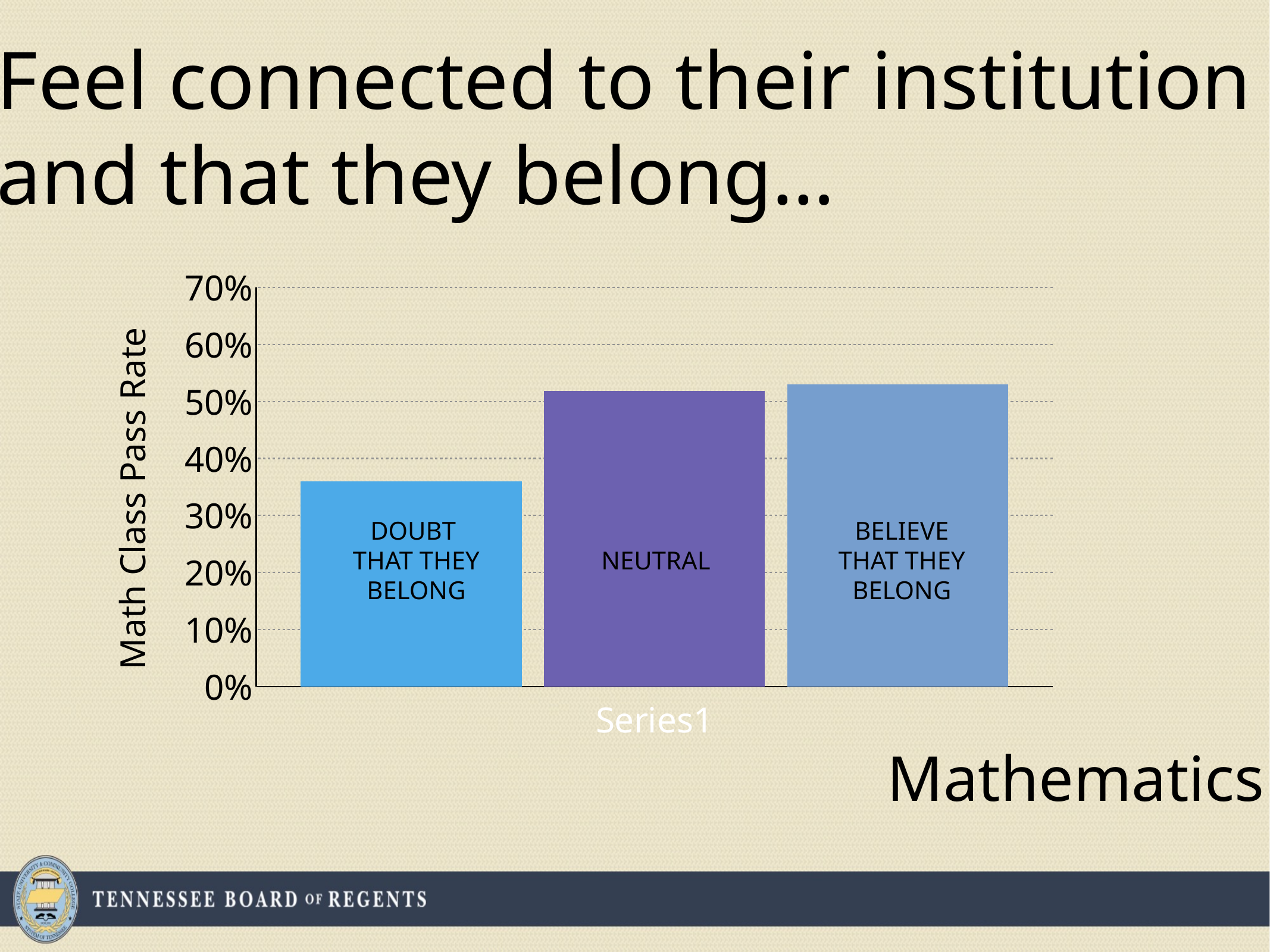
What kind of chart is shown on the slide? bar chart Is the Math Class Pass Rate for DOUBT THAT THEY BELONG greater or less than 30%? greater Which has a higher Math Class Pass Rate, DOUBT THAT THEY BELONG or NEUTRAL? NEUTRAL Is the Math Class Pass Rate for NEUTRAL greater or less than 50%? greater How many bars are plotted in the chart? 3 Is the Math Class Pass Rate for BELIEVE THAT THEY BELONG greater or less than 60%? less What is the highest value shown on the vertical axis of the chart? 70% What is the label on the vertical axis of the chart? Math Class Pass Rate Which has a higher Math Class Pass Rate, DOUBT THAT THEY BELONG or BELIEVE THAT THEY BELONG? BELIEVE THAT THEY BELONG Which category has the lowest Math Class Pass Rate? DOUBT THAT THEY BELONG